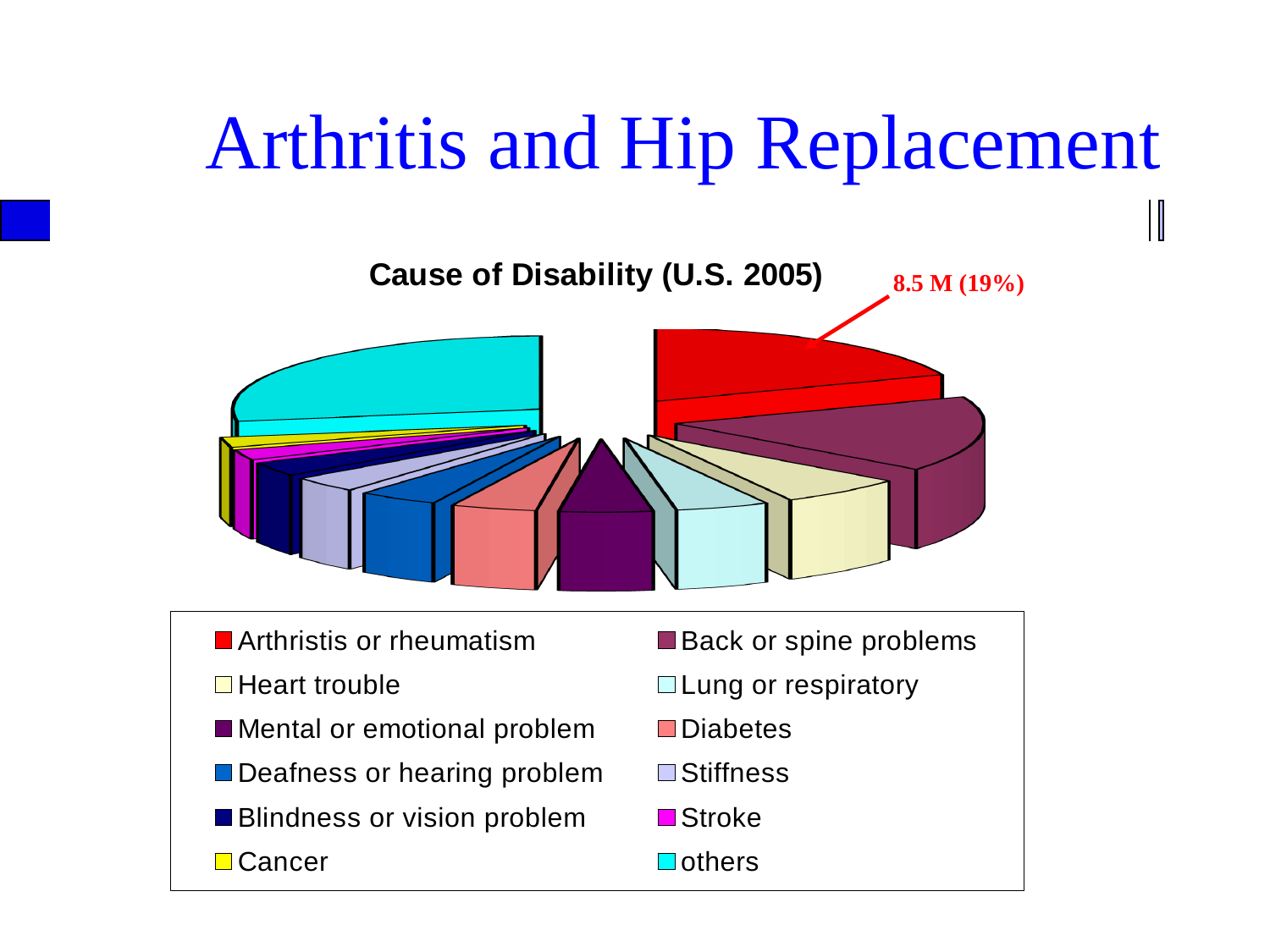
What is the title of the chart? Cause of Disability (U.S. 2005) Which slice is larger, Back or spine problems or Stroke? Back or spine problems What kind of chart is shown on the slide? pie chart Which category does the slice labelled 8.5 M (19%) belong to? Arthristis or rheumatism Which category is shown in cyan in the legend? others What value is labelled for the Arthristis or rheumatism slice? 8.5 M (19%) What share of the pie does the Arthristis or rheumatism slice represent? 19% Which slice is larger, Heart trouble or Cancer? Heart trouble How many categories does the legend of the pie chart list? 12 Which slice is larger, Arthristis or rheumatism or Cancer? Arthristis or rheumatism